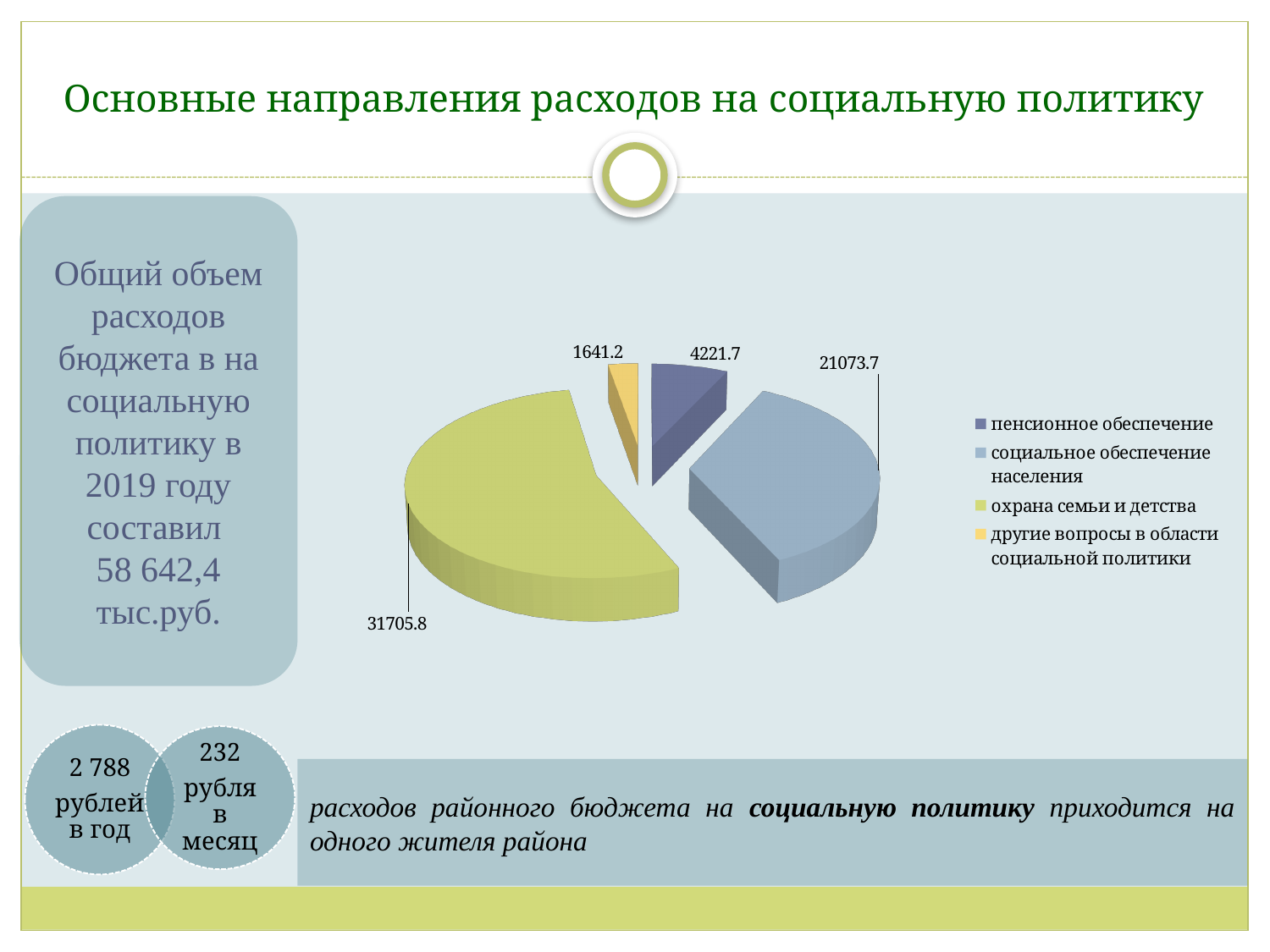
Which category has the smallest slice of the pie? другие вопросы в области социальной политики What colour is the slice for охрана семьи и детства? green How many categories does the pie chart show? 4 What is the value for пенсионное обеспечение? 4221.7 What is the difference between the values for пенсионное обеспечение and другие вопросы в области социальной политики? 2580.5 Which category has the largest slice of the pie? охрана семьи и детства What is the difference between the values for охрана семьи и детства and социальное обеспечение населения? 10632.1 What is the value for другие вопросы в области социальной политики? 1641.2 What kind of chart is shown on the slide? pie chart What is the value for социальное обеспечение населения? 21073.7 What is the value for охрана семьи и детства? 31705.8 Which is larger: пенсионное обеспечение or социальное обеспечение населения? социальное обеспечение населения